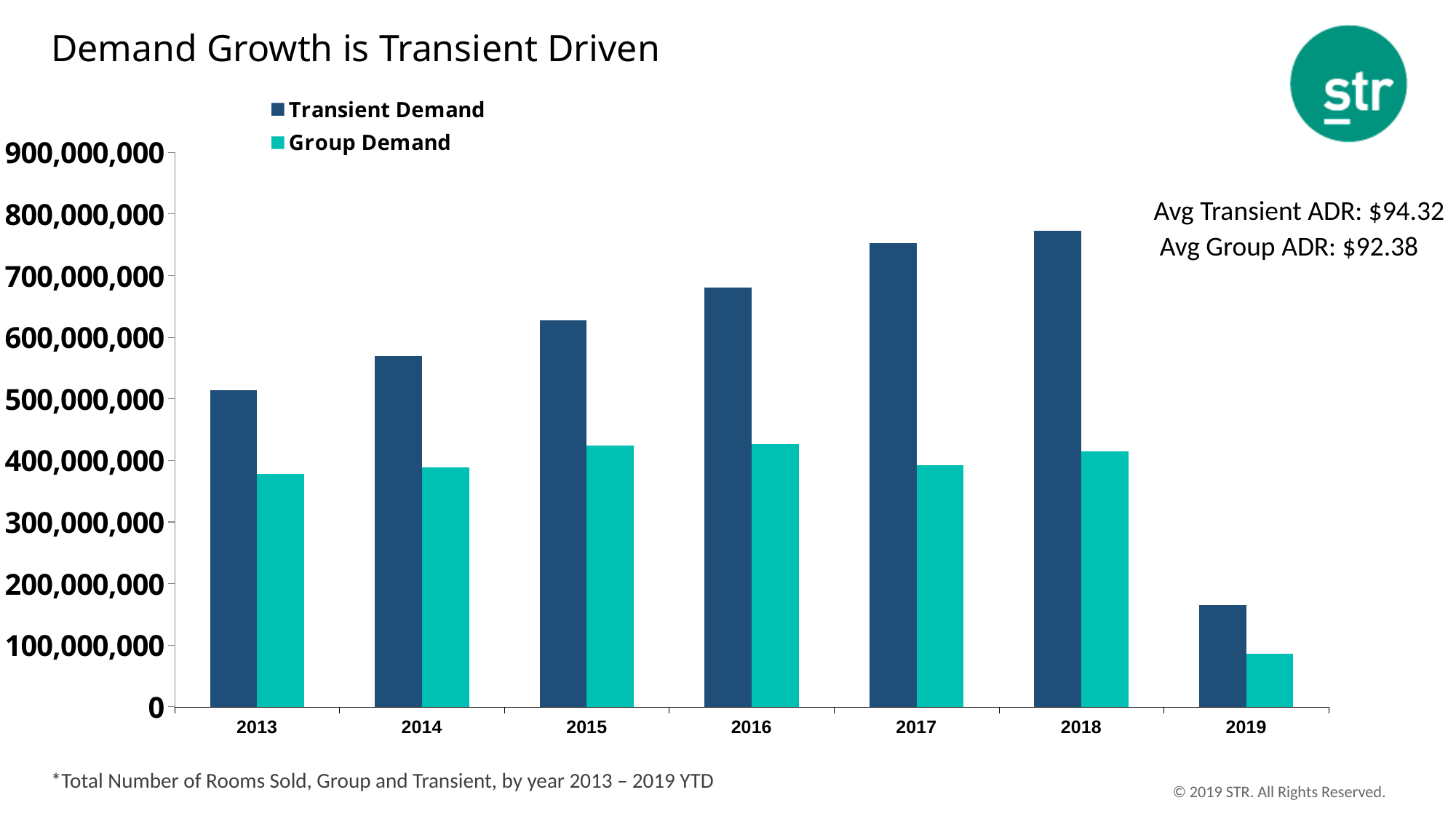
What kind of chart is shown on the slide? bar chart In 2016, which is larger, Transient Demand or Group Demand? Transient Demand Which year has the highest Transient Demand? 2018 Which year has the lowest Transient Demand? 2019 Which series is shown in the dark blue bars? Transient Demand Does Transient Demand rise or fall from 2013 to 2018? rise Is the Transient Demand value for 2019 greater or less than 200,000,000? less How many series does the legend list? 2 How many years are shown on the x axis? 7 Which year has the lowest Group Demand? 2019 Is the Transient Demand value for 2017 greater or less than 700,000,000? greater Is the Group Demand value for 2013 greater or less than 400,000,000? less